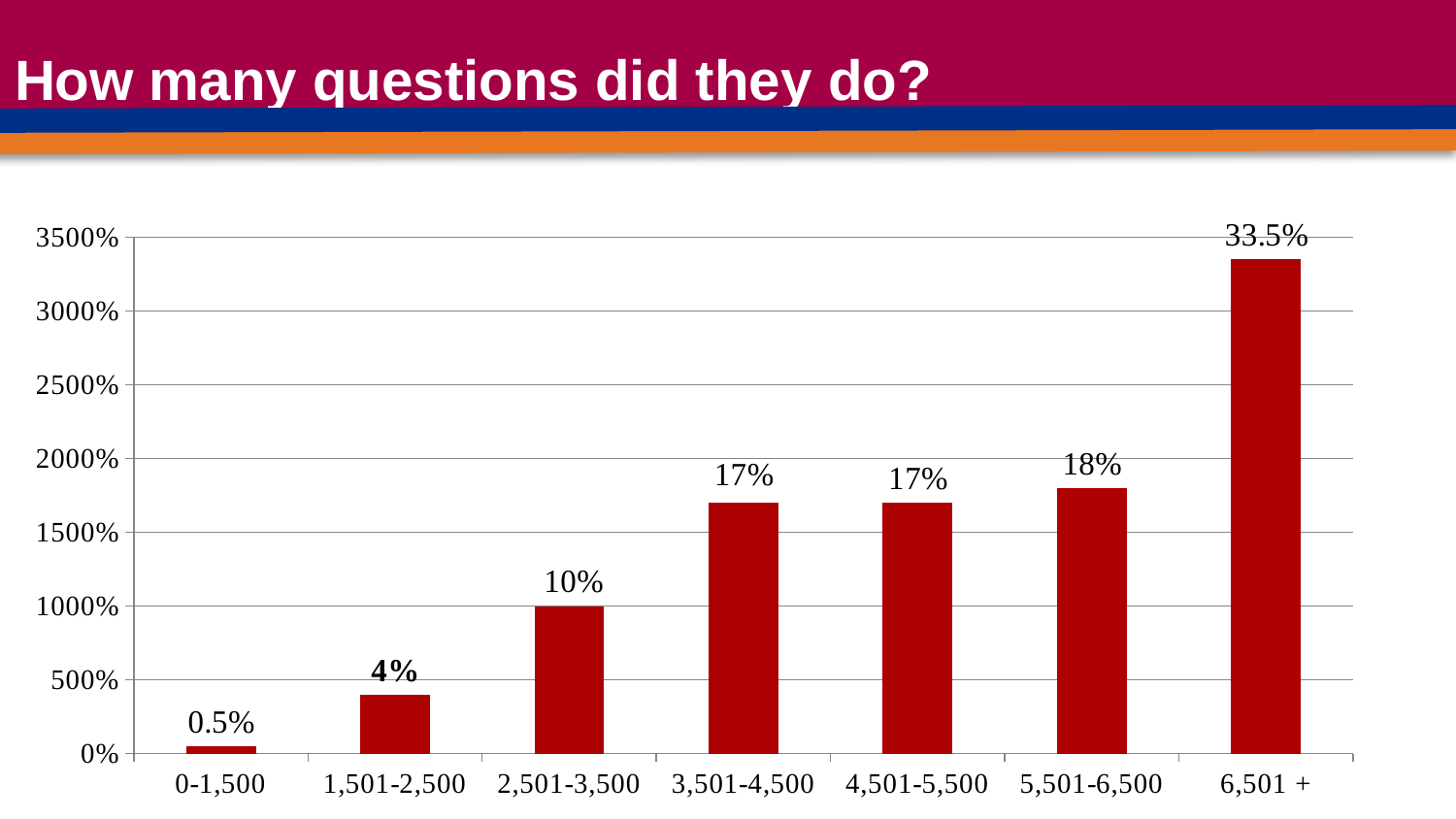
What kind of chart is shown on the slide? Bar chart What is the title of the slide containing the chart? How many questions did they do? What is the value shown for the 5,501-6,500 category? 18% Which category has the lowest value? 0-1,500 Which category has the highest value? 6,501 + What is the difference between the values for 2,501-3,500 and 1,501-2,500? 6% Which is larger, the value for 3,501-4,500 or the value for 2,501-3,500? 3,501-4,500 What is the difference between the values for 6,501 + and 5,501-6,500? 15.5% What is the value shown for the 0-1,500 category? 0.5% What is the value shown for the 2,501-3,500 category? 10% How many categories are shown on the x axis? 7 What is the value shown for the 6,501 + category? 33.5%